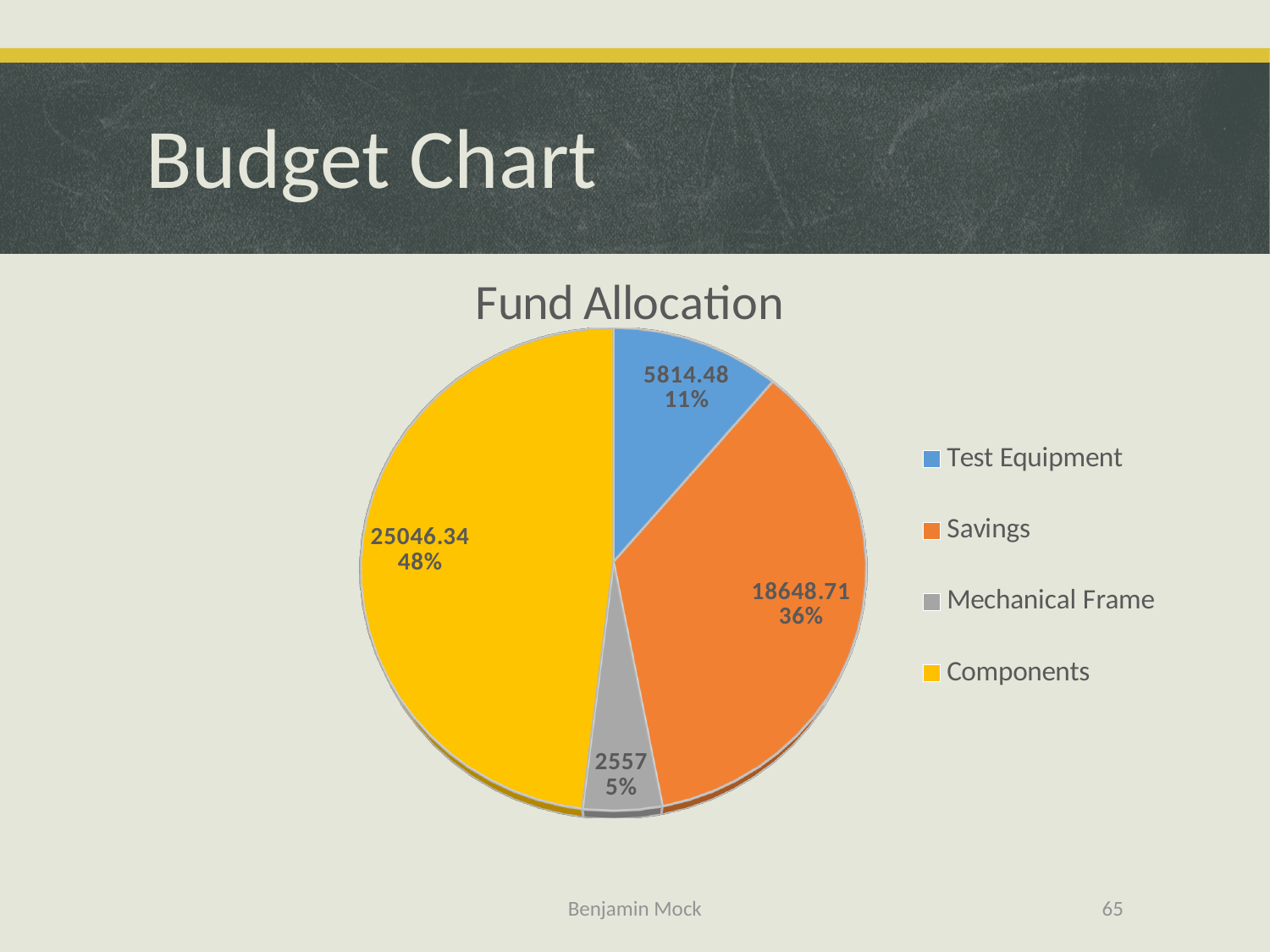
What percentage share of the Fund Allocation pie does Savings represent? 36% What value is shown for Test Equipment in the Fund Allocation pie chart? 5814.48 Which is larger in the Fund Allocation pie chart, Savings or Test Equipment? Savings What percentage share of the Fund Allocation pie does Test Equipment represent? 11% Which category has the smallest slice in the Fund Allocation pie chart? Mechanical Frame How many categories are shown in the Fund Allocation pie chart? 4 What value is shown for Mechanical Frame in the Fund Allocation pie chart? 2557 What is the difference between the Components value and the Savings value in the Fund Allocation pie chart? 6397.63 What value is shown for Components in the Fund Allocation pie chart? 25046.34 What type of chart is shown on the slide? Pie chart Which category has the largest slice in the Fund Allocation pie chart? Components What value is shown for Savings in the Fund Allocation pie chart? 18648.71